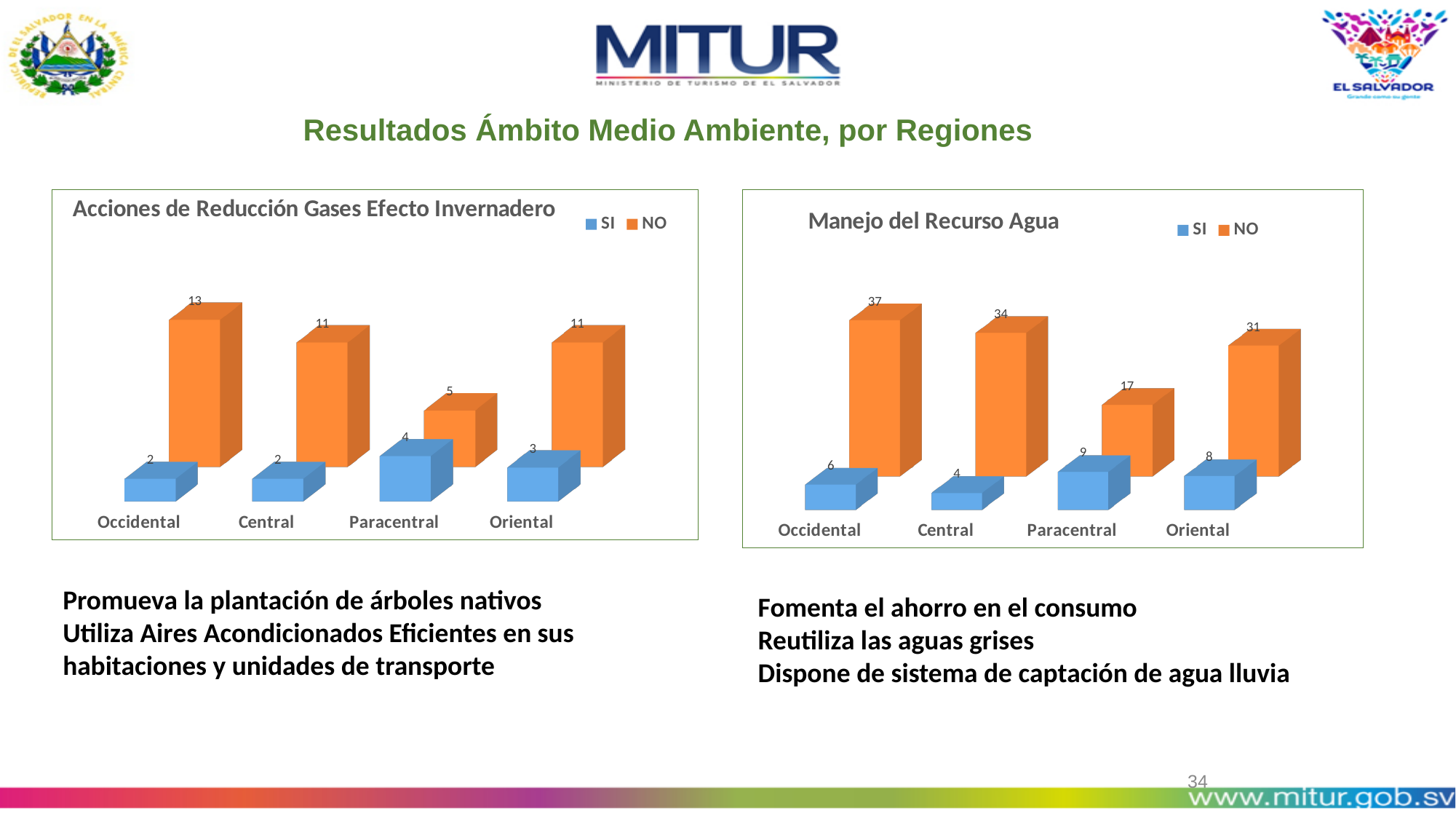
In the 'Manejo del Recurso Agua' chart, which region has the lowest SI value? Central In the 'Manejo del Recurso Agua' chart, what is the SI value for Paracentral? 9 In the 'Acciones de Reducción Gases Efecto Invernadero' chart, what is the SI value for Paracentral? 4 How many series does the legend of the 'Manejo del Recurso Agua' chart list? 2 In the 'Manejo del Recurso Agua' chart, what is the difference between the NO values for Occidental and Oriental? 6 In the 'Manejo del Recurso Agua' chart, what is the NO value for Central? 34 In the 'Manejo del Recurso Agua' chart, is the SI value for Oriental larger or smaller than the SI value for Paracentral? smaller In the 'Manejo del Recurso Agua' chart, which region has the highest NO value? Occidental In the 'Acciones de Reducción Gases Efecto Invernadero' chart, what is the difference between the NO and SI values for Oriental? 8 In the 'Acciones de Reducción Gases Efecto Invernadero' chart, which region has the lowest NO value? Paracentral In the 'Acciones de Reducción Gases Efecto Invernadero' chart, how many regions are shown on the x axis? 4 In the 'Acciones de Reducción Gases Efecto Invernadero' chart, what is the NO value for Occidental? 13